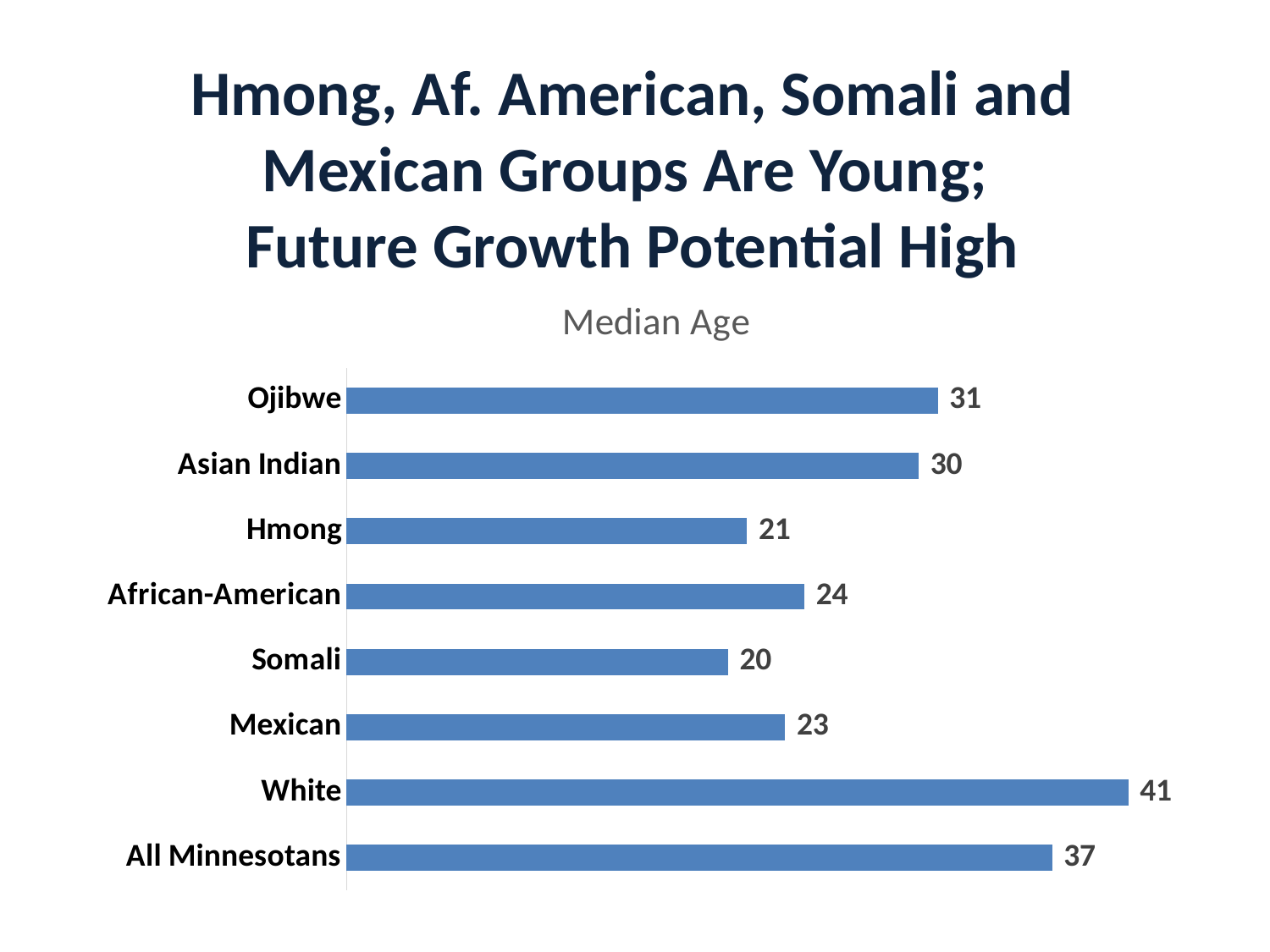
Which has a lower median age, Hmong or Mexican? Hmong What kind of chart is shown on the slide? Bar chart Which group has the highest median age? White Which group has the lowest median age? Somali What is the median age for All Minnesotans? 37 What is the title of the chart? Median Age What is the difference between the median age for White and the median age for Hmong? 20 What is the difference between the median age for All Minnesotans and the median age for Mexican? 14 How many groups are shown in the chart? 8 What is the median age for Somali? 20 What is the median age for Ojibwe? 31 Which has a higher median age, Asian Indian or African-American? Asian Indian